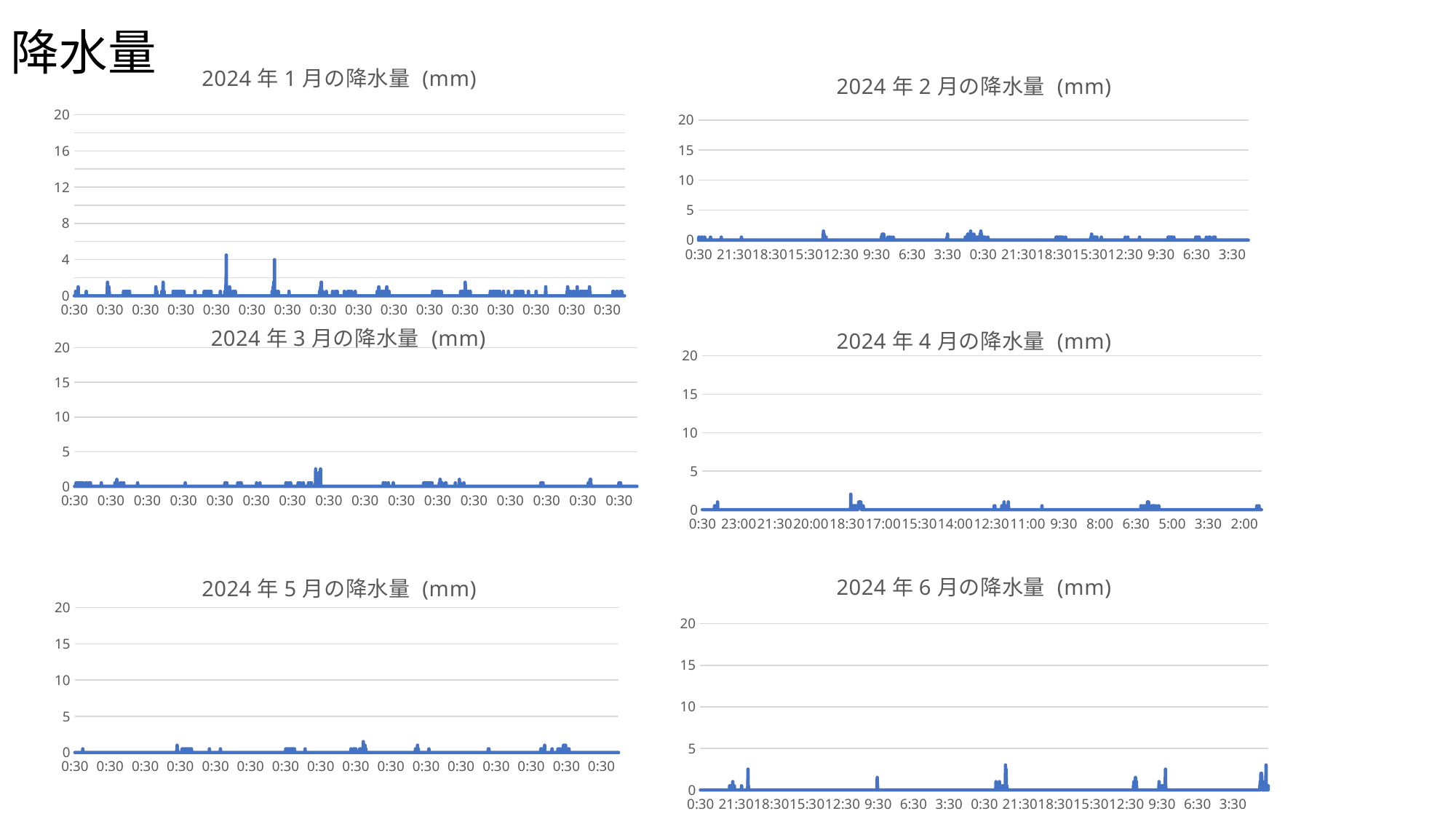
In the 2024年4月の降水量 (mm) chart, is the highest value greater or less than 5? less In the 2024年1月の降水量 (mm) chart, is the highest value greater or less than 8? less What is the title of the chart in the top-right position of the slide? 2024年2月の降水量 (mm) In the 2024年6月の降水量 (mm) chart, is the highest value greater or less than 10? less What kind of chart is the 2024年1月の降水量 (mm) chart? line chart What is the maximum value shown on the y axis of the 2024年6月の降水量 (mm) chart? 20 How many charts are shown on the slide? 6